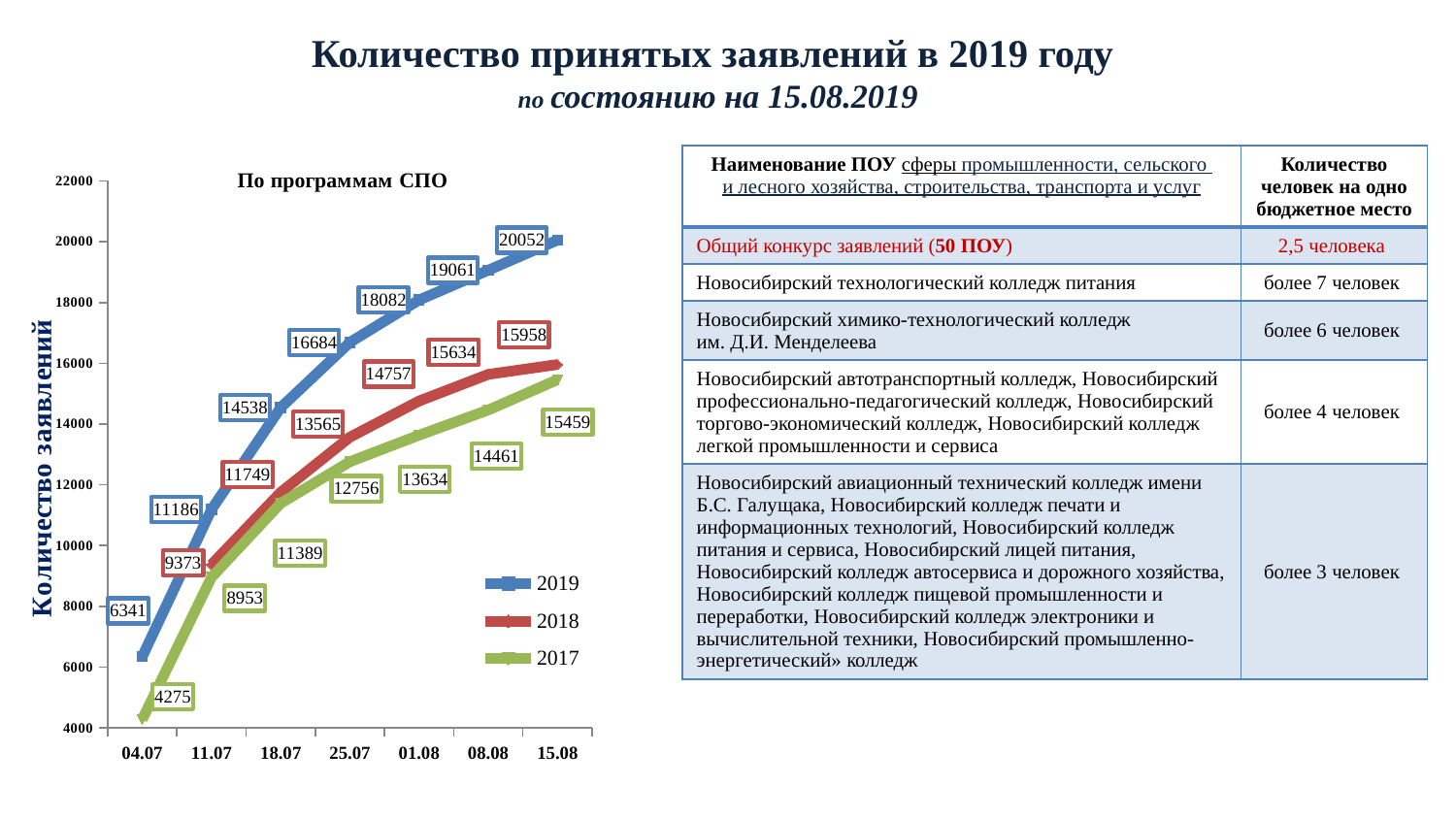
What is the value for 2017 at 04.07? 4275 Do the values of the 2019 series rise or fall along the x axis? rise What is the title of the chart? По программам СПО What is the last (15.08) value for the 2018 series? 15958 How many series does the chart legend list? 3 What is the value for 2019 at 15.08? 20052 How many dates are shown on the x axis? 7 What is the difference between the 2019 and 2017 values at 15.08? 4593 Which series has the highest value at 15.08? 2019 What type of chart is shown on the slide? line chart What is the value for 2019 at 04.07? 6341 What is the value for 2017 at 15.08? 15459